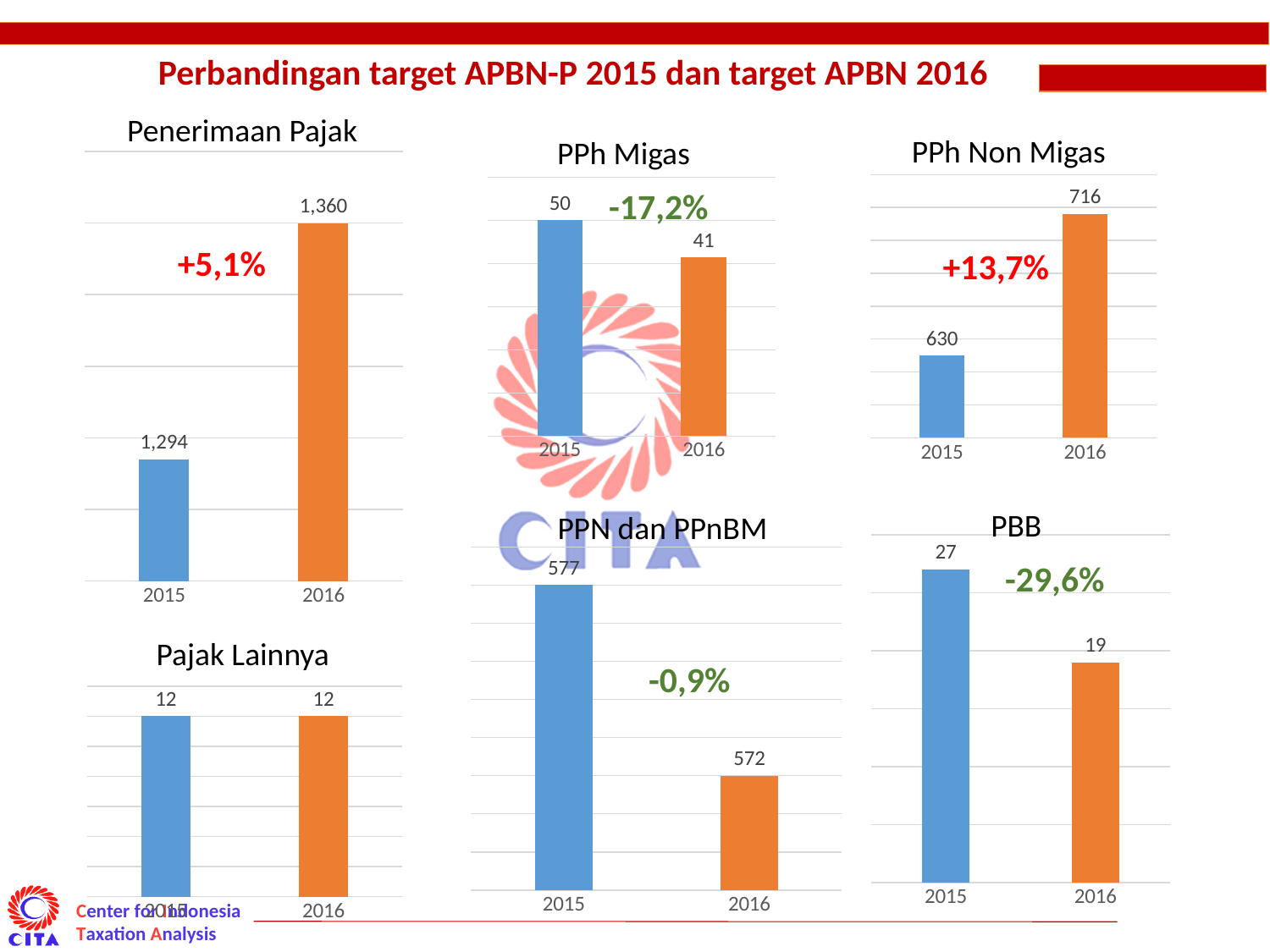
In the 'PPh Migas' chart, what is the difference between the 2015 and 2016 values? 9 In the 'PPh Migas' chart, what is the value for 2016? 41 In the 'PPN dan PPnBM' chart, do the values rise or fall from 2015 to 2016? fall In the 'PPh Non Migas' chart, what is the difference between the 2016 and 2015 values? 86 What kind of chart is the 'PBB' chart? bar chart In the 'Penerimaan Pajak' chart, what is the value for 2015? 1,294 In the 'PBB' chart, what is the difference between the 2015 and 2016 values? 8 In the 'Pajak Lainnya' chart, what is the value for 2015? 12 In the 'PPh Non Migas' chart, which year has the higher value? 2016 In the 'Penerimaan Pajak' chart, what is the value for 2016? 1,360 In the 'PBB' chart, which year has the lowest value? 2016 In the 'PPN dan PPnBM' chart, what is the value for 2016? 572